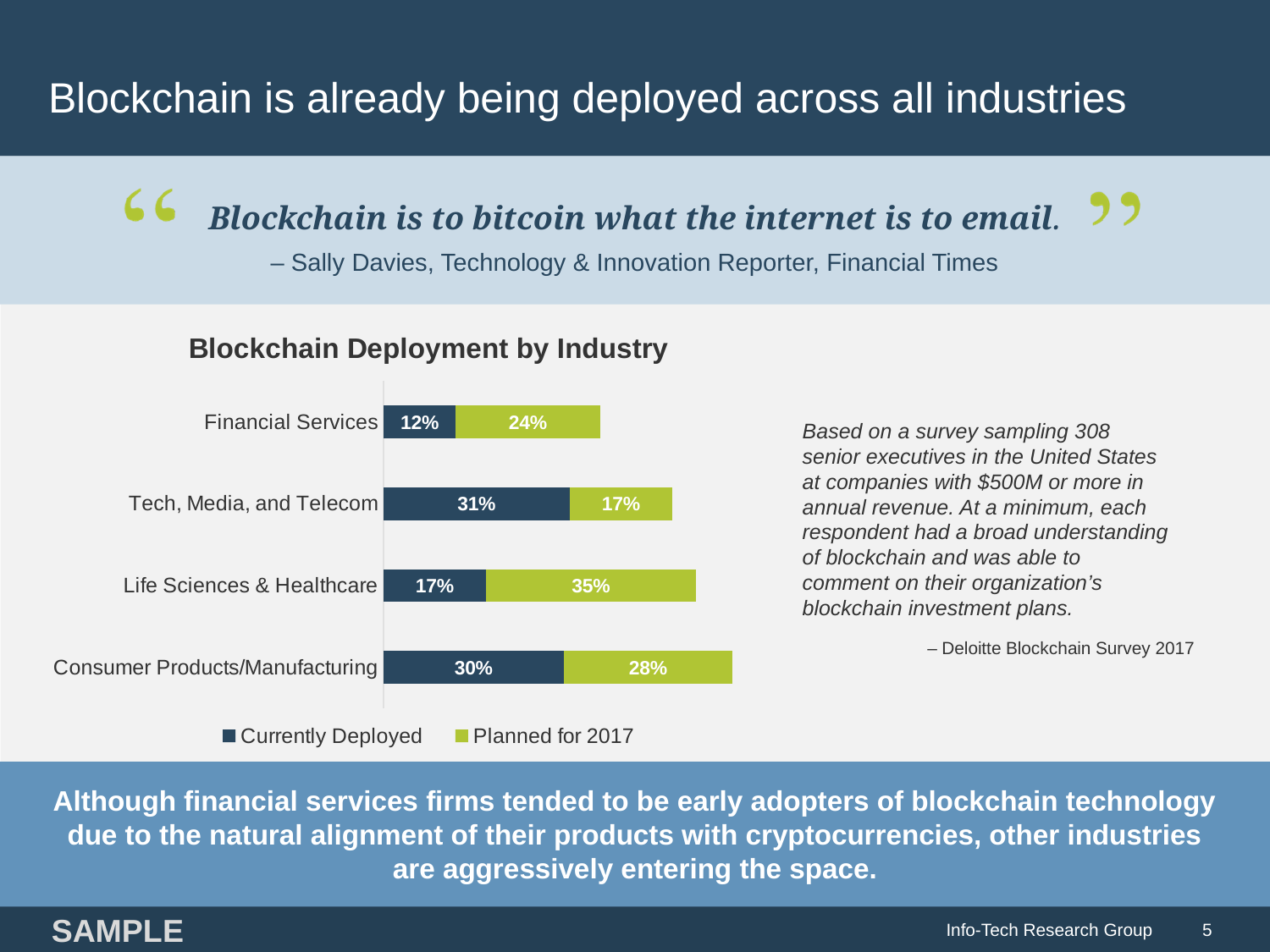
How many series does the legend list? 2 What is the total of the stacked bar for Financial Services? 36% What is the Currently Deployed value for Consumer Products/Manufacturing? 30% What is the Currently Deployed value for Financial Services? 12% Which industry has the highest Currently Deployed value? Tech, Media, and Telecom Which is larger for Financial Services: Currently Deployed or Planned for 2017? Planned for 2017 How many industries are shown in the chart? 4 Which industry has the lowest Planned for 2017 value? Tech, Media, and Telecom What is the total of the stacked bar for Consumer Products/Manufacturing? 58% What is the difference between the Planned for 2017 and Currently Deployed values for Life Sciences & Healthcare? 18% What type of chart is shown on the slide? Stacked bar chart What is the Planned for 2017 value for Life Sciences & Healthcare? 35%